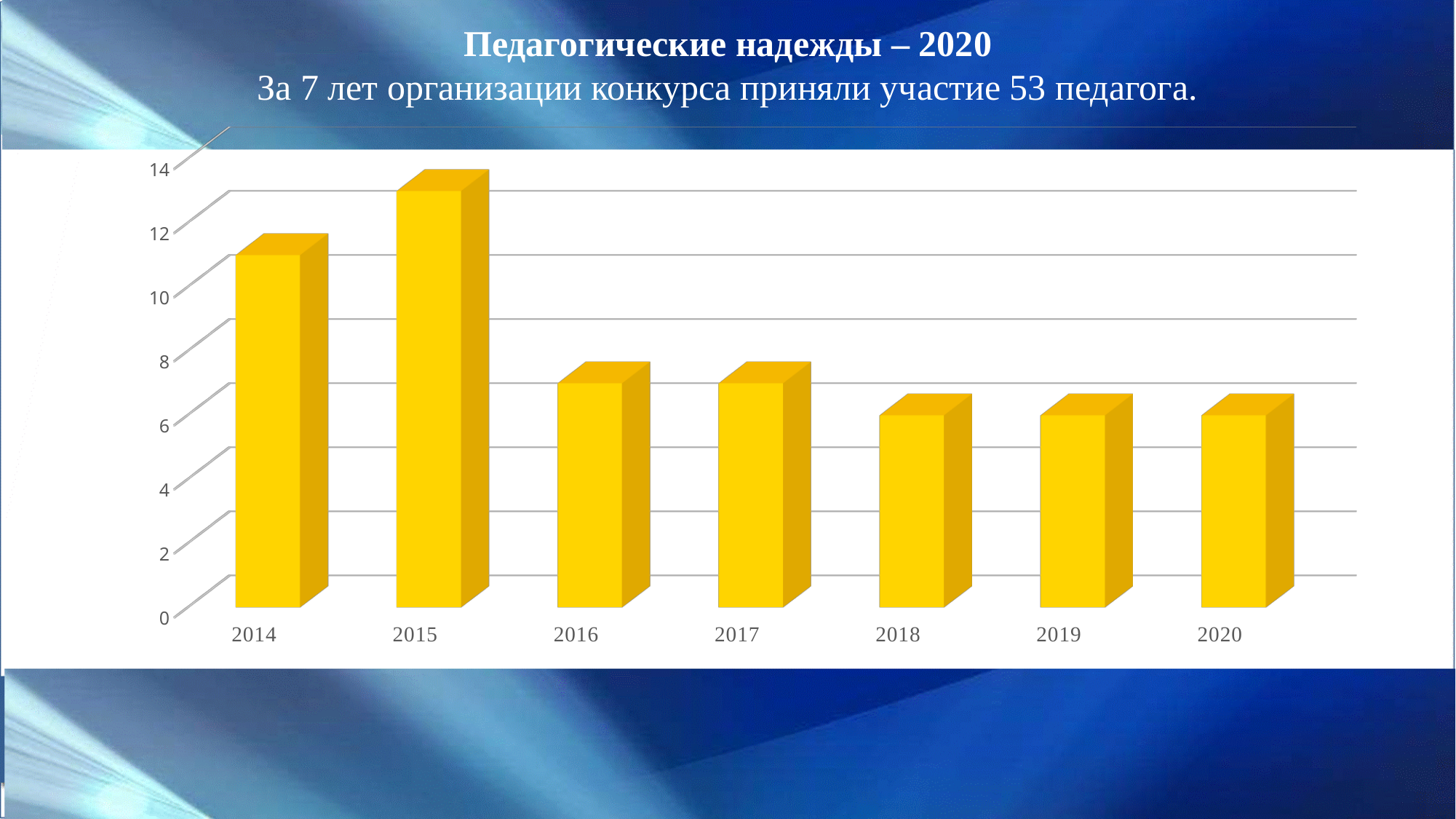
Is the value for 2020 greater or less than 8? less Is the value for 2017 greater or less than 6? greater Which year has the highest bar in the chart? 2015 What colour are the bars in the chart? yellow What kind of chart is shown on the slide? bar chart How many years are shown on the x axis of the chart? 7 Do the values generally rise or fall from 2015 to 2020? fall Which is larger, the value for 2014 or the value for 2016? 2014 Is the value for 2014 greater or less than 10? greater Which is larger, the value for 2015 or the value for 2018? 2015